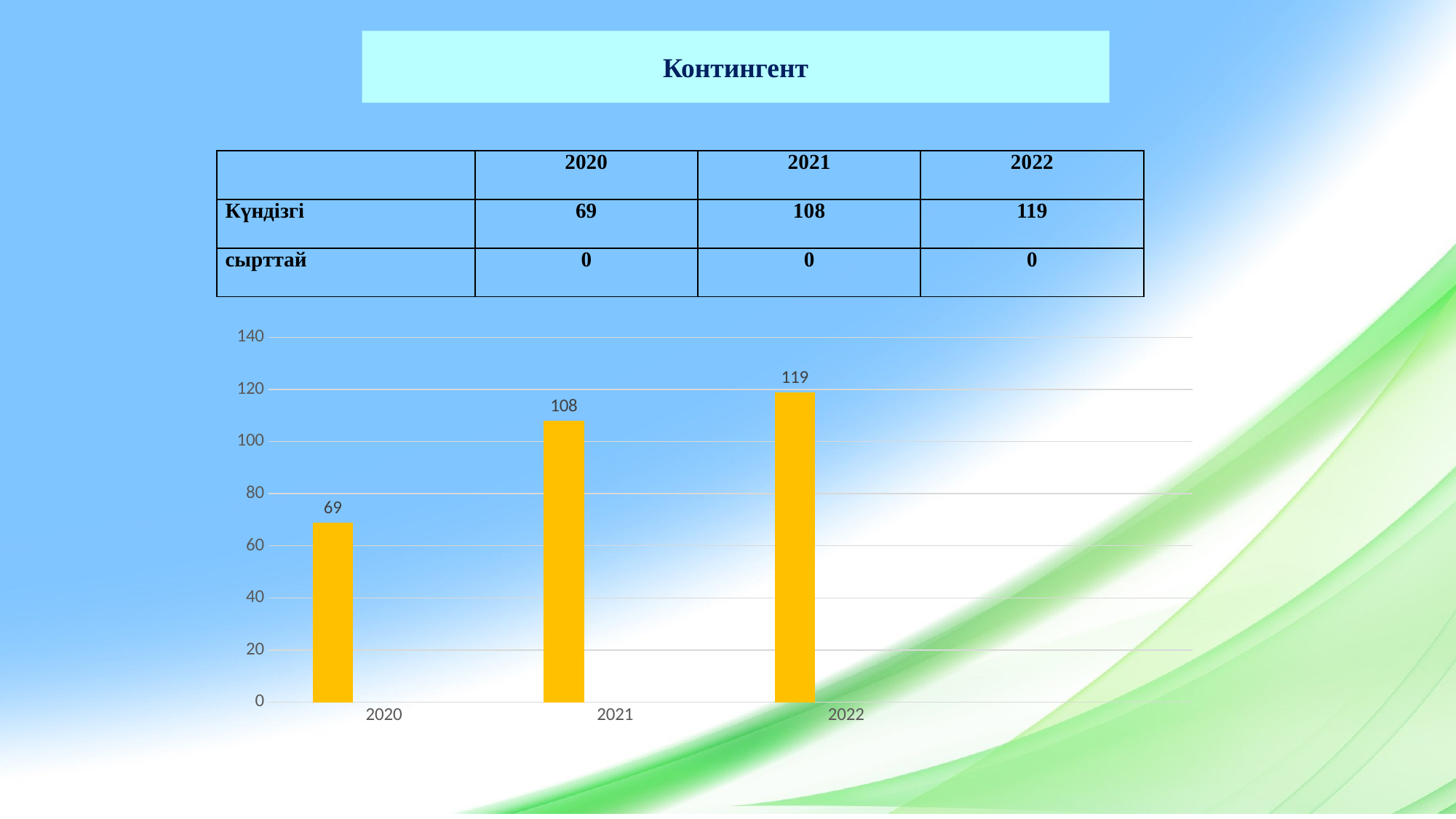
What is the value shown for 2020 in the bar chart? 69 What is the difference between the values for 2021 and 2020 in the bar chart? 39 Which year has the highest value in the bar chart? 2022 What kind of chart is shown on the slide? bar chart Is the value for 2021 in the bar chart greater or less than 100? greater What is the value shown for 2022 in the bar chart? 119 What is the difference between the values for 2022 and 2020 in the bar chart? 50 Which is larger in the bar chart, the value for 2021 or the value for 2022? 2022 How many bars are shown in the bar chart? 3 Do the values in the bar chart rise or fall from 2020 to 2022? rise What is the value shown for 2021 in the bar chart? 108 Which year has the lowest value in the bar chart? 2020